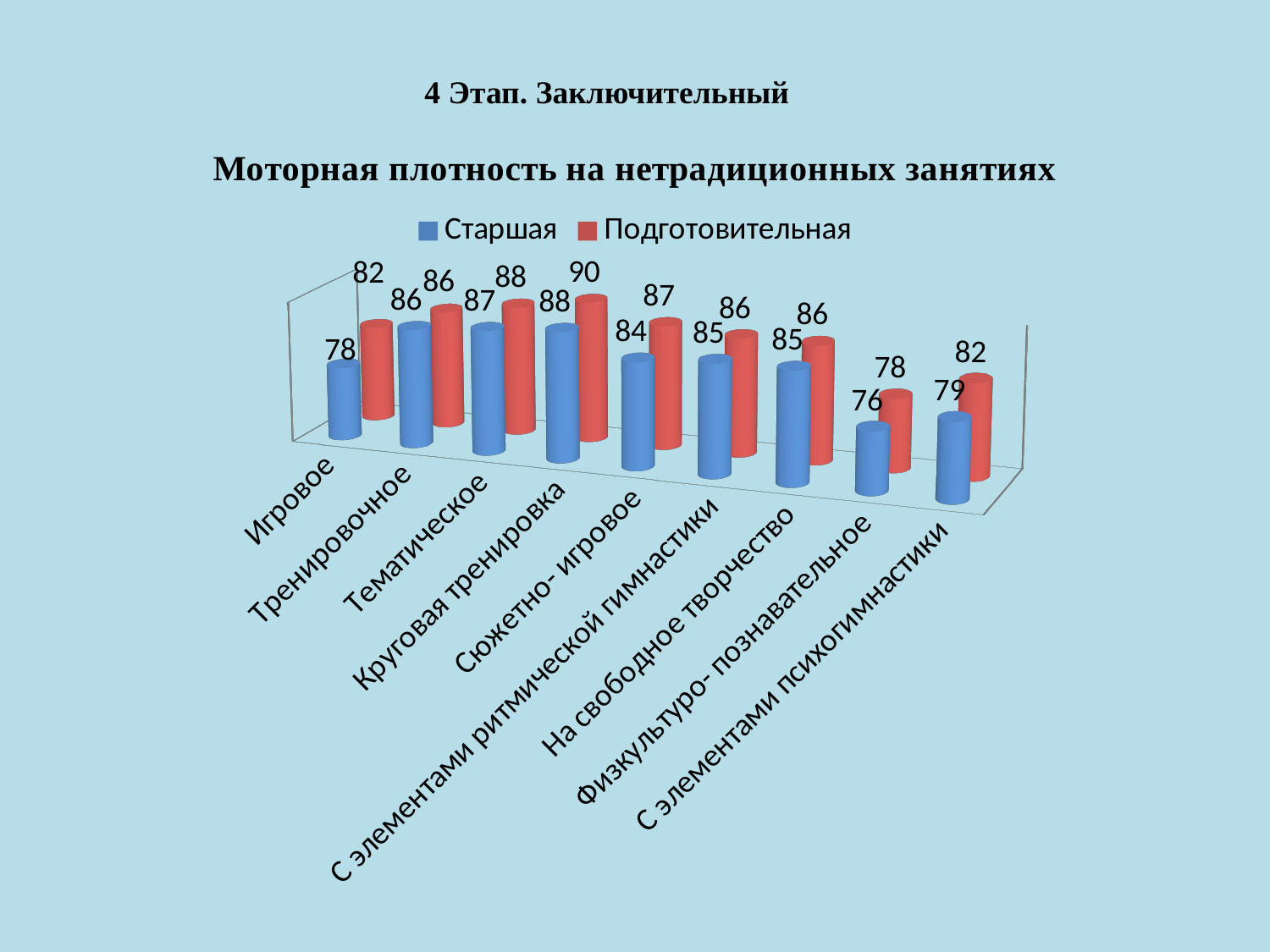
Which category has the lowest value for the Старшая series? Физкультуро-познавательное Which category has the highest value for the Подготовительная series? Круговая тренировка What kind of chart is shown on the slide? Bar chart What is the value for Старшая in the Физкультуро-познавательное category? 76 Which is larger in the Сюжетно-игровое category: the Старшая value or the Подготовительная value? Подготовительная What is the value for Подготовительная in the Круговая тренировка category? 90 What is the value for Подготовительная in the Сюжетно-игровое category? 87 What is the value for Старшая in the Игровое category? 78 How many categories are shown on the x axis? 9 How many series does the legend list? 2 What is the title of the chart? Моторная плотность на нетрадиционных занятиях What is the difference between the Подготовительная and Старшая values in the Игровое category? 4